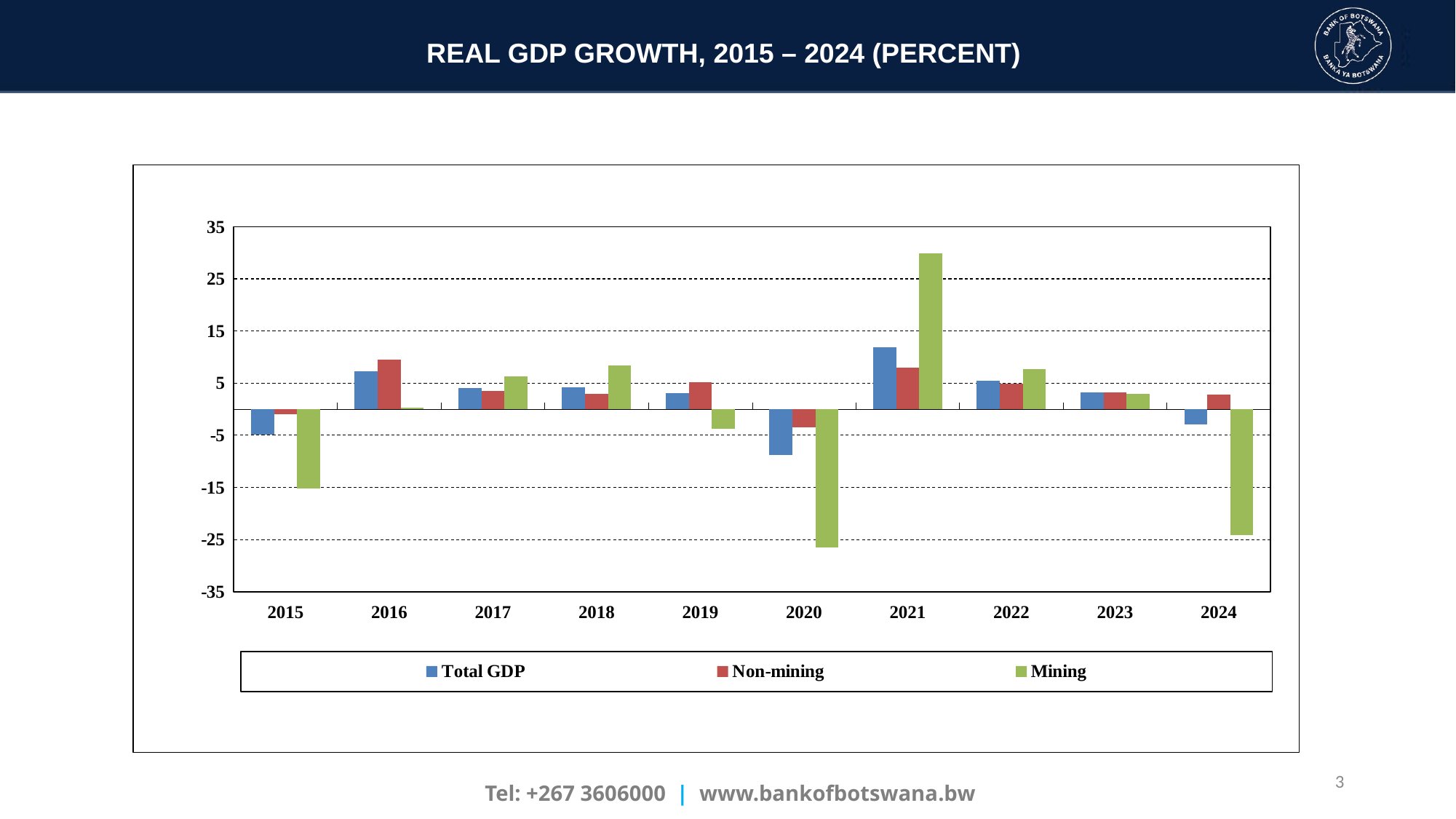
In which year is the Mining bar lowest? 2020 Is the value for Mining in 2021 greater or less than 25? greater In which year is the Total GDP bar lowest? 2020 Which colour represents the Mining series in the legend? Green Is the value for Mining in 2020 greater or less than -15? less How many series does the legend list? 3 How many years are shown on the x axis? 10 In which year is the Mining bar highest? 2021 What kind of chart is shown on the slide? Bar chart Is the value for Total GDP in 2021 greater or less than 5? greater In which year is the Total GDP bar highest? 2021 In 2021, which is larger: Mining or Non-mining? Mining